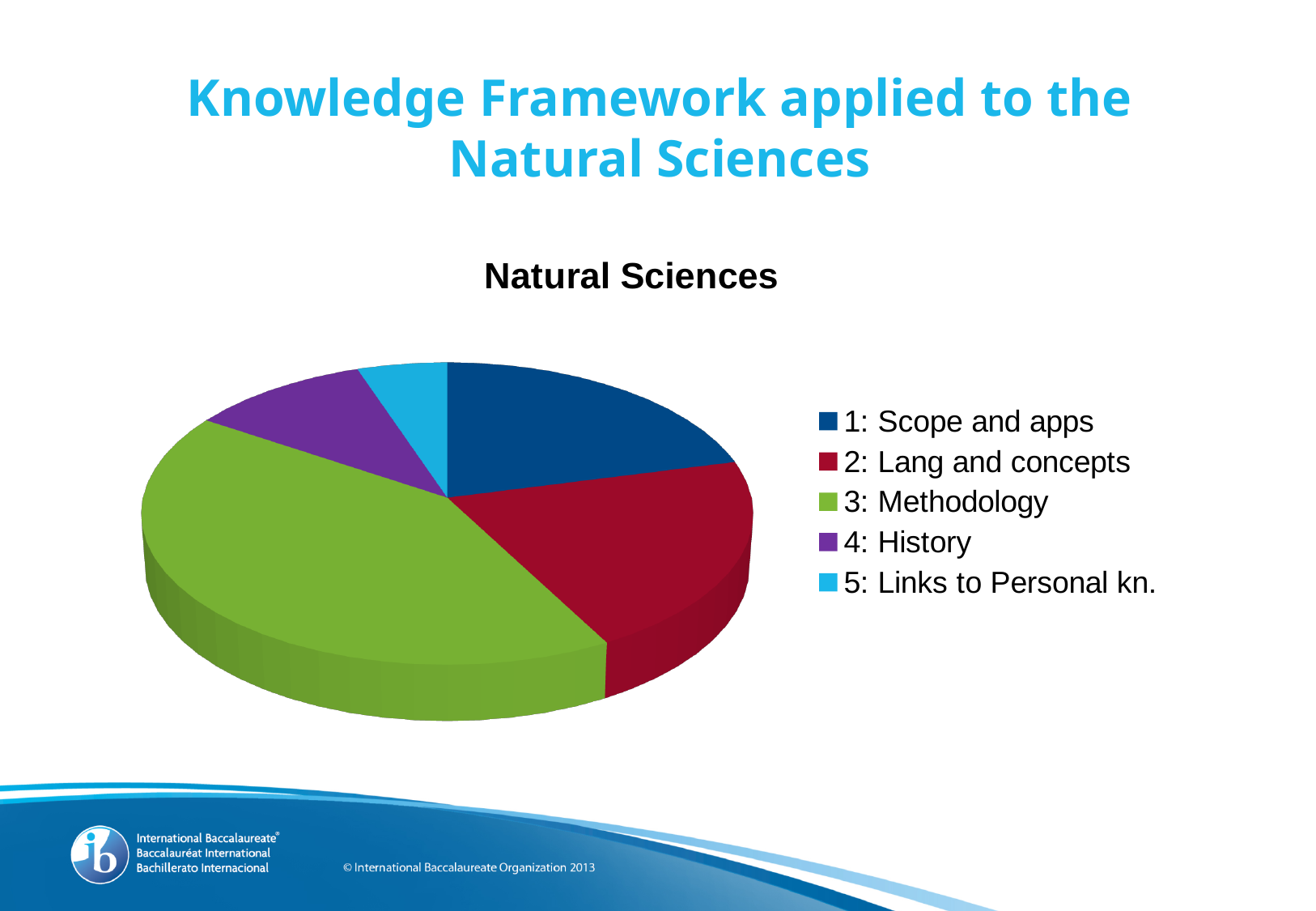
How many slices does the pie chart have? 5 Which category has the largest slice of the pie? 3: Methodology How many entries does the legend list? 5 What colour is the slice for 3: Methodology? green Which category has the smallest slice of the pie? 5: Links to Personal kn. What kind of chart is shown on the slide? pie chart Which slice is larger, 4: History or 5: Links to Personal kn.? 4: History What is the title of the chart? Natural Sciences Which slice is larger, 2: Lang and concepts or 5: Links to Personal kn.? 2: Lang and concepts Which slice is larger, 1: Scope and apps or 4: History? 1: Scope and apps